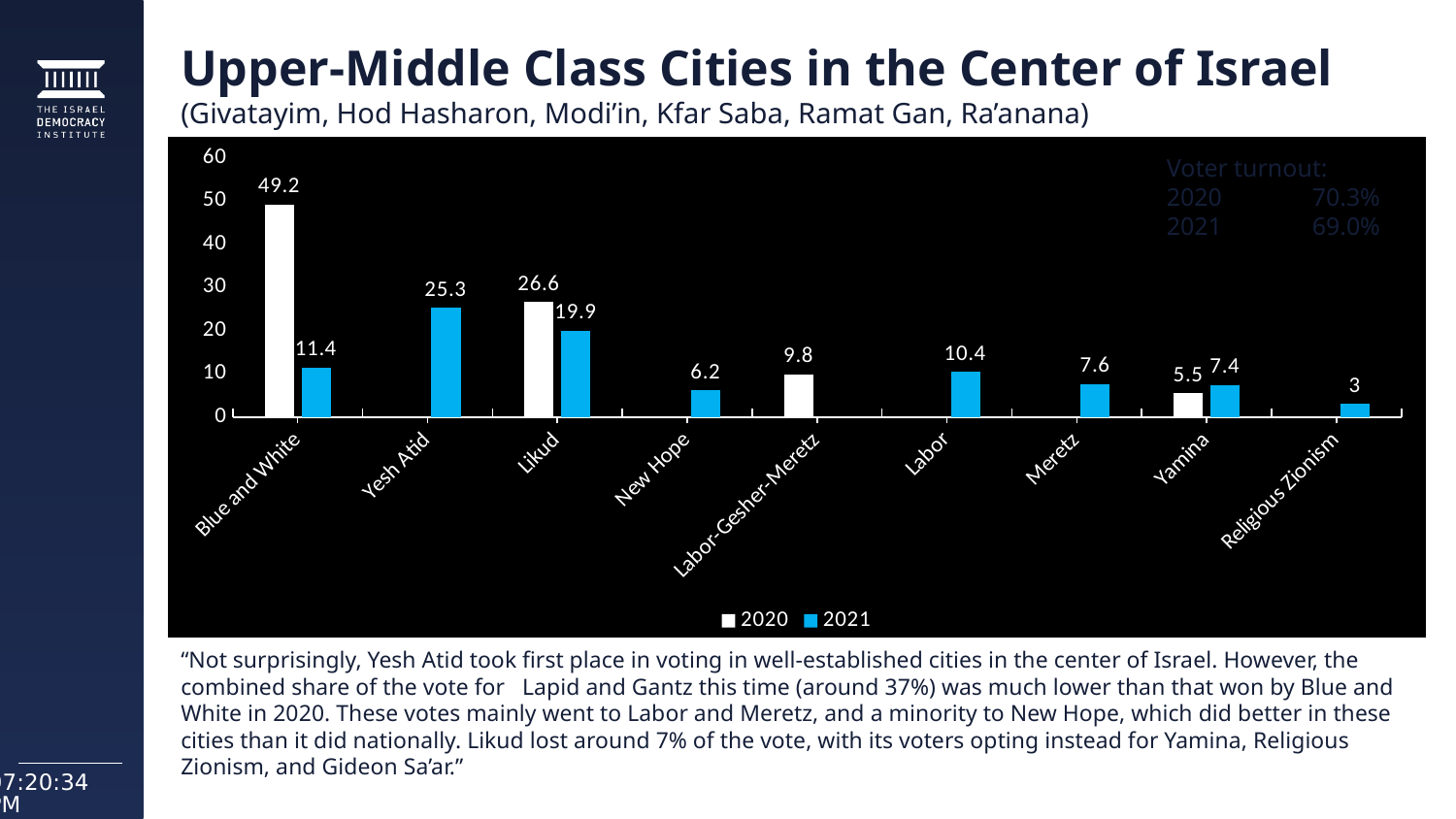
What kind of chart is shown on the slide? Bar chart How many series does the legend list? 2 How many categories are shown on the x axis? 9 What was the value for Yesh Atid in 2021? 25.3 What is the difference between the 2020 and 2021 values for Likud? 6.7 What was the value for Blue and White in 2020? 49.2 What was the value for Likud in 2021? 19.9 What is the difference between the 2020 and 2021 values for Blue and White? 37.8 Which category has the lowest 2021 value? Religious Zionism What was the value for Labor-Gesher-Meretz in 2020? 9.8 Which is larger for Yamina: the 2020 value or the 2021 value? 2021 Which category has the highest 2021 value? Yesh Atid